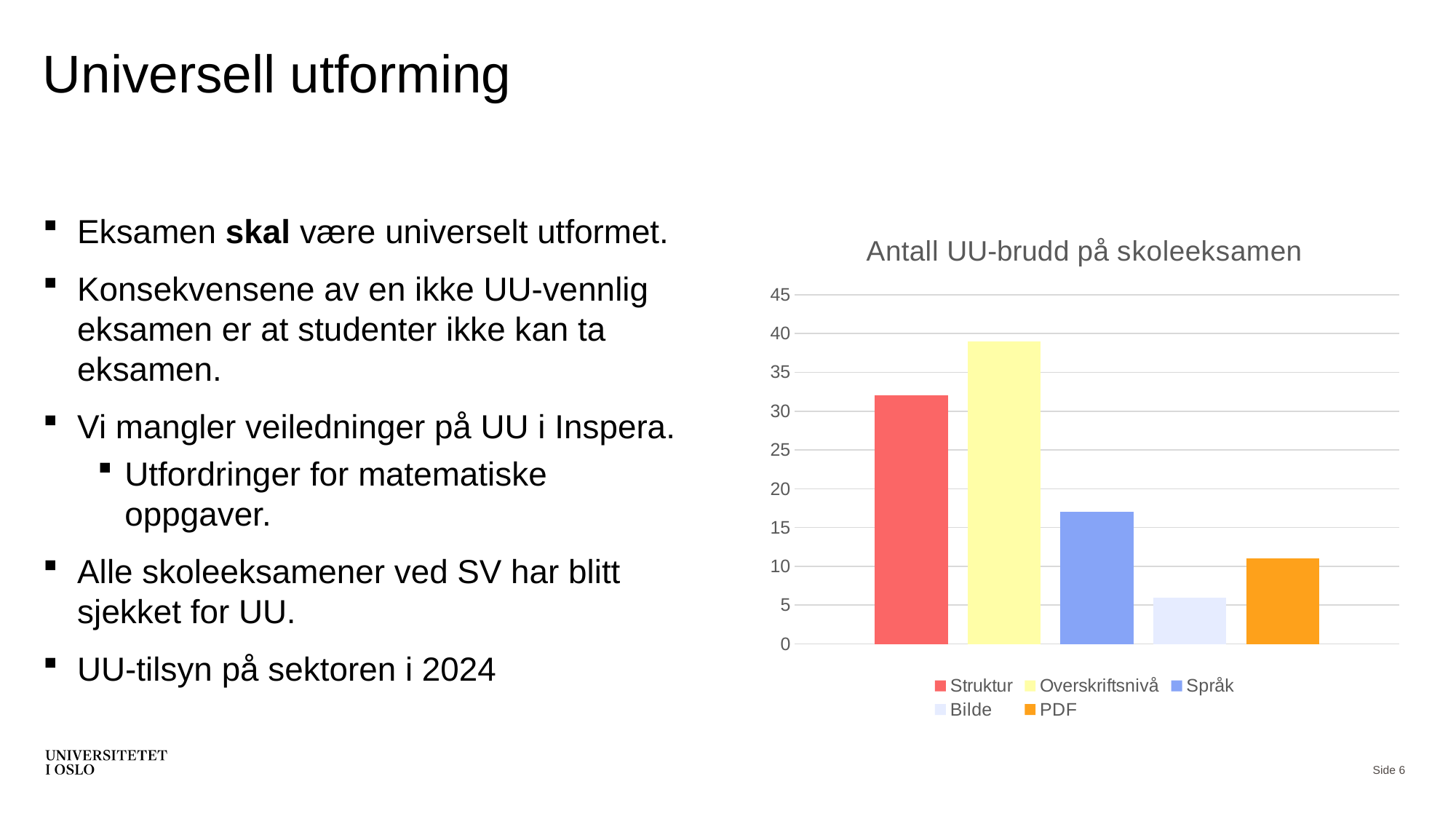
How many bars are plotted in the chart? 5 Is the value for PDF greater or less than 10? greater Which is larger, the value for PDF or the value for Bilde? PDF Is the value for Struktur greater or less than 30? greater Is the value for Språk greater or less than 15? greater How many series does the chart legend list? 5 Which category has the lowest number of UU-brudd? Bilde What is the title of the chart? Antall UU-brudd på skoleeksamen What kind of chart is shown on the slide? bar chart Which category has the highest number of UU-brudd? Overskriftsnivå Which is larger, the value for Struktur or the value for Språk? Struktur